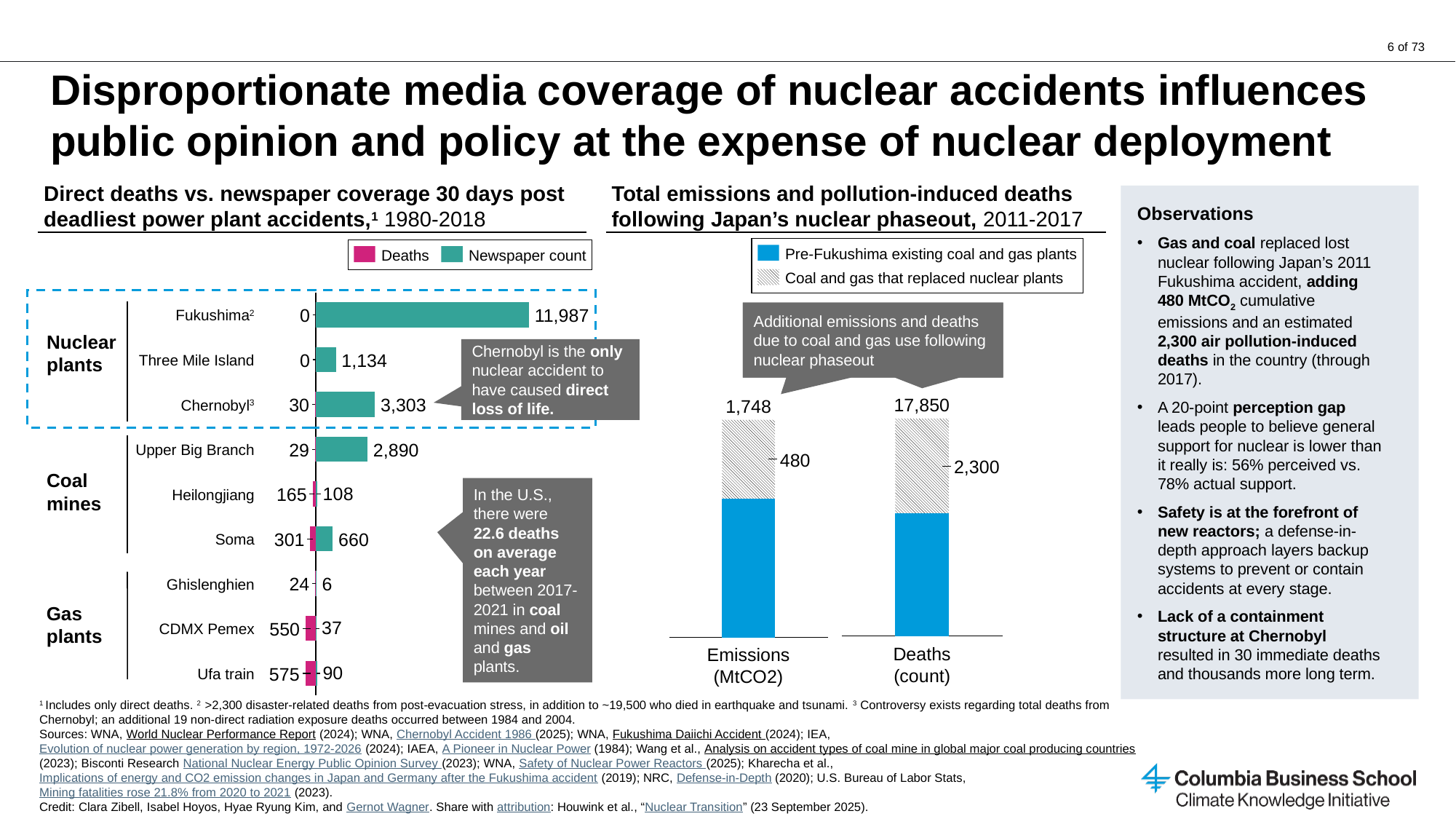
In the chart 'Direct deaths vs. newspaper coverage 30 days post deadliest power plant accidents', how many accidents are listed? 9 In the chart 'Direct deaths vs. newspaper coverage 30 days post deadliest power plant accidents', which accident has the highest newspaper count? Fukushima In the chart 'Direct deaths vs. newspaper coverage 30 days post deadliest power plant accidents', what is the difference between the newspaper counts for Chernobyl and Upper Big Branch? 413 In the chart 'Direct deaths vs. newspaper coverage 30 days post deadliest power plant accidents', which accident has the lowest newspaper count? Ghislenghien In the chart 'Total emissions and pollution-induced deaths following Japan's nuclear phaseout', how much of the Emissions (MtCO2) bar is attributed to coal and gas that replaced nuclear plants? 480 In the chart 'Total emissions and pollution-induced deaths following Japan's nuclear phaseout', what is the total of the Deaths (count) bar? 17,850 In the chart 'Total emissions and pollution-induced deaths following Japan's nuclear phaseout', what is the value of the pre-Fukushima existing coal and gas plants segment of the Emissions (MtCO2) bar? 1,268 In the chart 'Direct deaths vs. newspaper coverage 30 days post deadliest power plant accidents', what is the newspaper count for Fukushima? 11,987 In the chart 'Direct deaths vs. newspaper coverage 30 days post deadliest power plant accidents', how many series does the legend list? 2 In the chart 'Direct deaths vs. newspaper coverage 30 days post deadliest power plant accidents', how many deaths are shown for Ufa train? 575 What kind of chart is 'Direct deaths vs. newspaper coverage 30 days post deadliest power plant accidents'? Bar chart In the chart 'Direct deaths vs. newspaper coverage 30 days post deadliest power plant accidents', which has more deaths, Soma or Heilongjiang? Soma